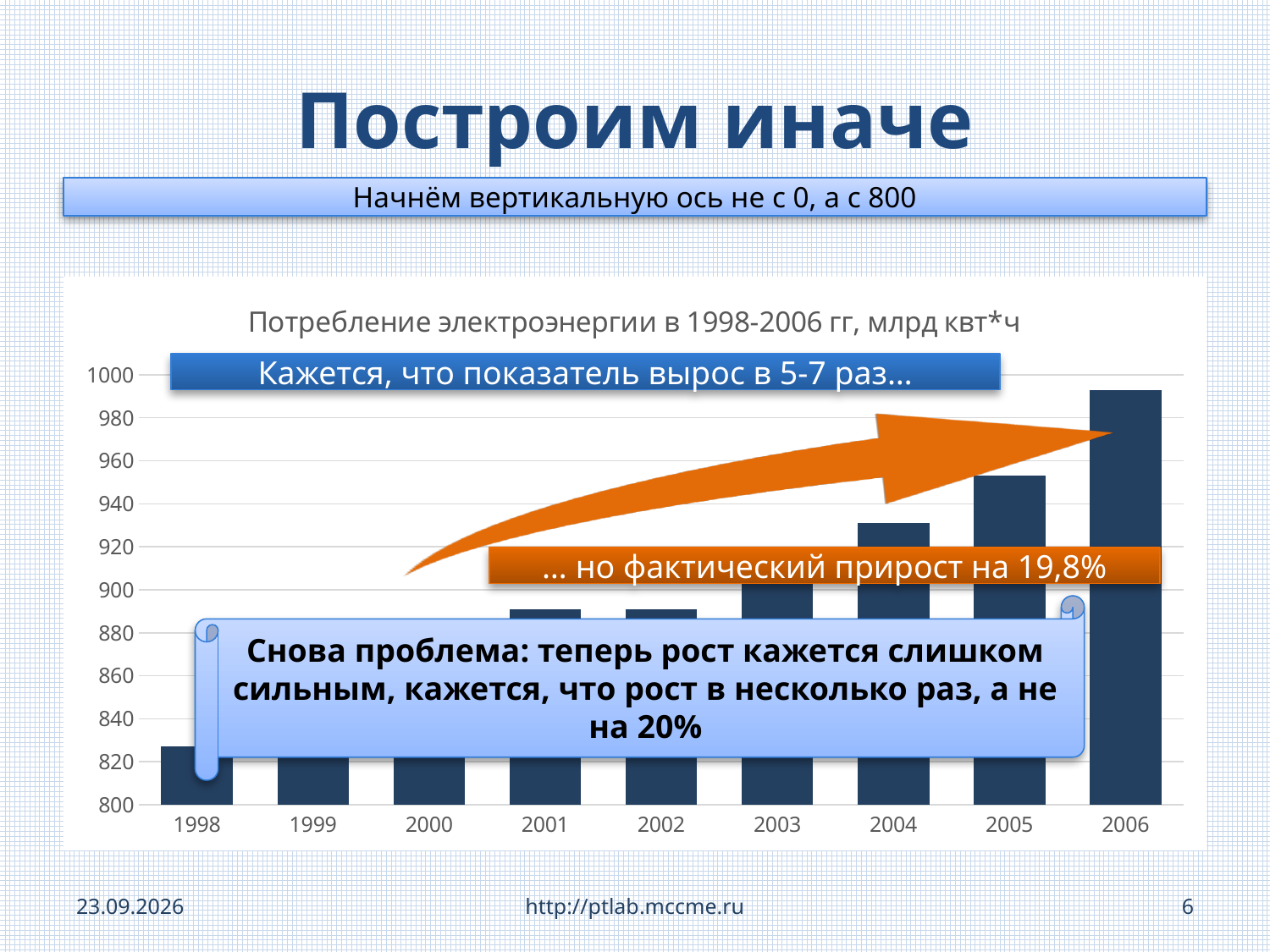
Which is larger, the value for 2005 or the value for 2006? 2006 Do the values generally rise or fall from 1998 to 2006? rise Is the value for 2006 greater or less than 980? greater What kind of chart is shown on the slide? bar chart Which year has the highest bar in the chart? 2006 Which year has the lowest bar in the chart? 1998 Is the value for 2004 greater or less than 920? greater Is the value for 2001 greater or less than 900? less How many years (categories) are plotted on the x axis of the chart? 9 At what value does the vertical axis of the chart start? 800